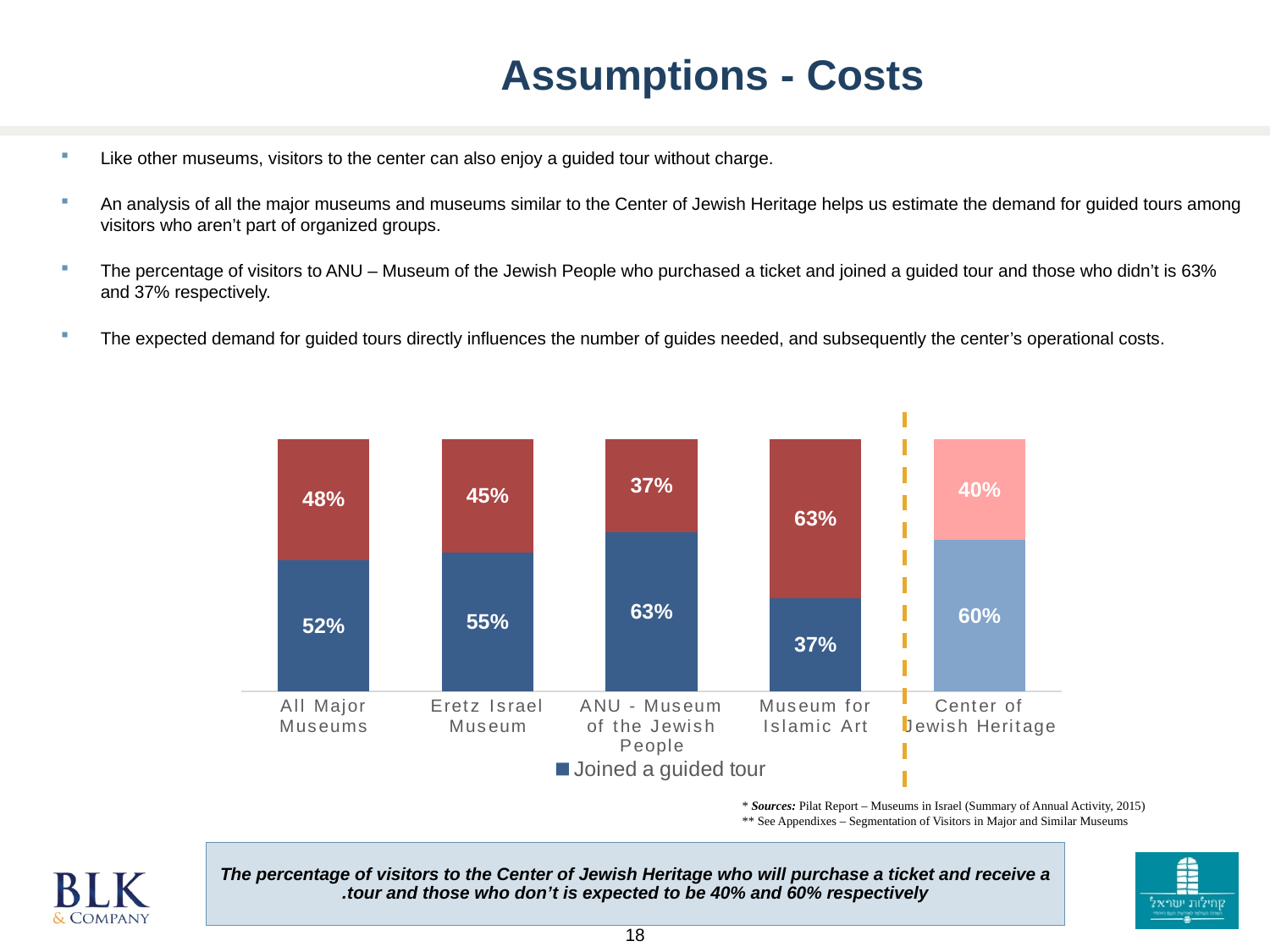
What value is shown on the upper (red) segment of the All Major Museums bar? 48% Which has a larger 'Joined a guided tour' value, All Major Museums or Eretz Israel Museum? Eretz Israel Museum What value is shown on the lower (blue) segment of the Center of Jewish Heritage bar? 60% What is the value of the 'Joined a guided tour' segment for Museum for Islamic Art? 37% What is the value of the 'Joined a guided tour' segment for Eretz Israel Museum? 55% How many series does the chart legend list? 1 Which category has the highest 'Joined a guided tour' value? ANU - Museum of the Jewish People What kind of chart is shown on the slide? Stacked bar chart Which category has the lowest 'Joined a guided tour' value? Museum for Islamic Art What is the difference between the 'Joined a guided tour' values for ANU - Museum of the Jewish People and Eretz Israel Museum? 8 percentage points How many categories are shown on the x axis of the chart? 5 What is the total of the two segments in the All Major Museums bar? 100%